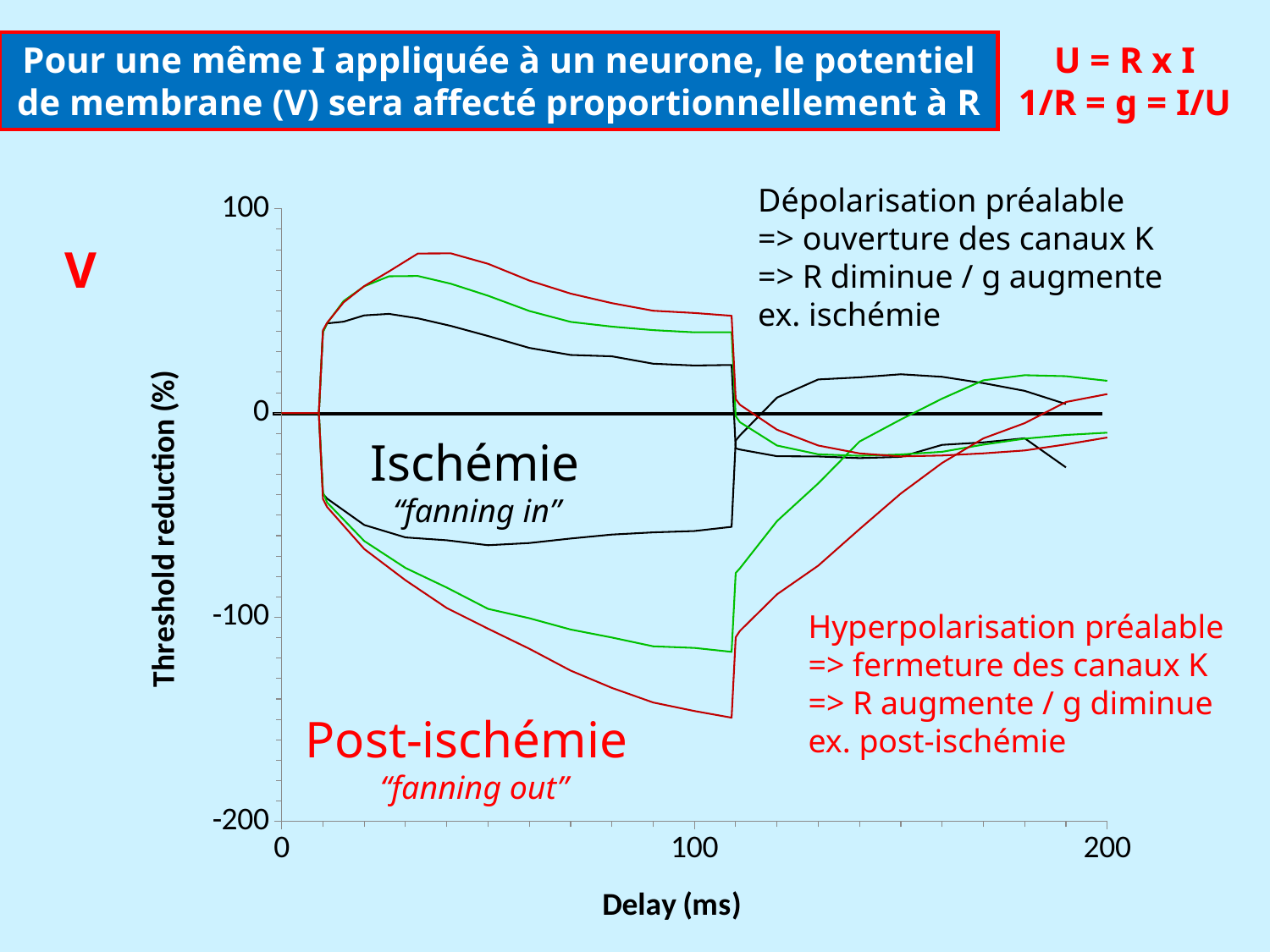
Is the lowest value reached by the green curve greater or less than -100? less Is the highest value reached by the green curve greater or less than 50? greater Between a delay of about 110 ms and 200 ms, do the lower (negative) curves rise or fall? rise Which curve reaches the lowest threshold reduction value, the red or the black one? red Which curve reaches the highest threshold reduction value, the red or the black one? red Is the highest value reached by the black curve greater or less than 100? less What is the label of the y axis of the chart? Threshold reduction (%) What is the label of the x axis of the chart? Delay (ms) What kind of chart is shown on the slide? line chart